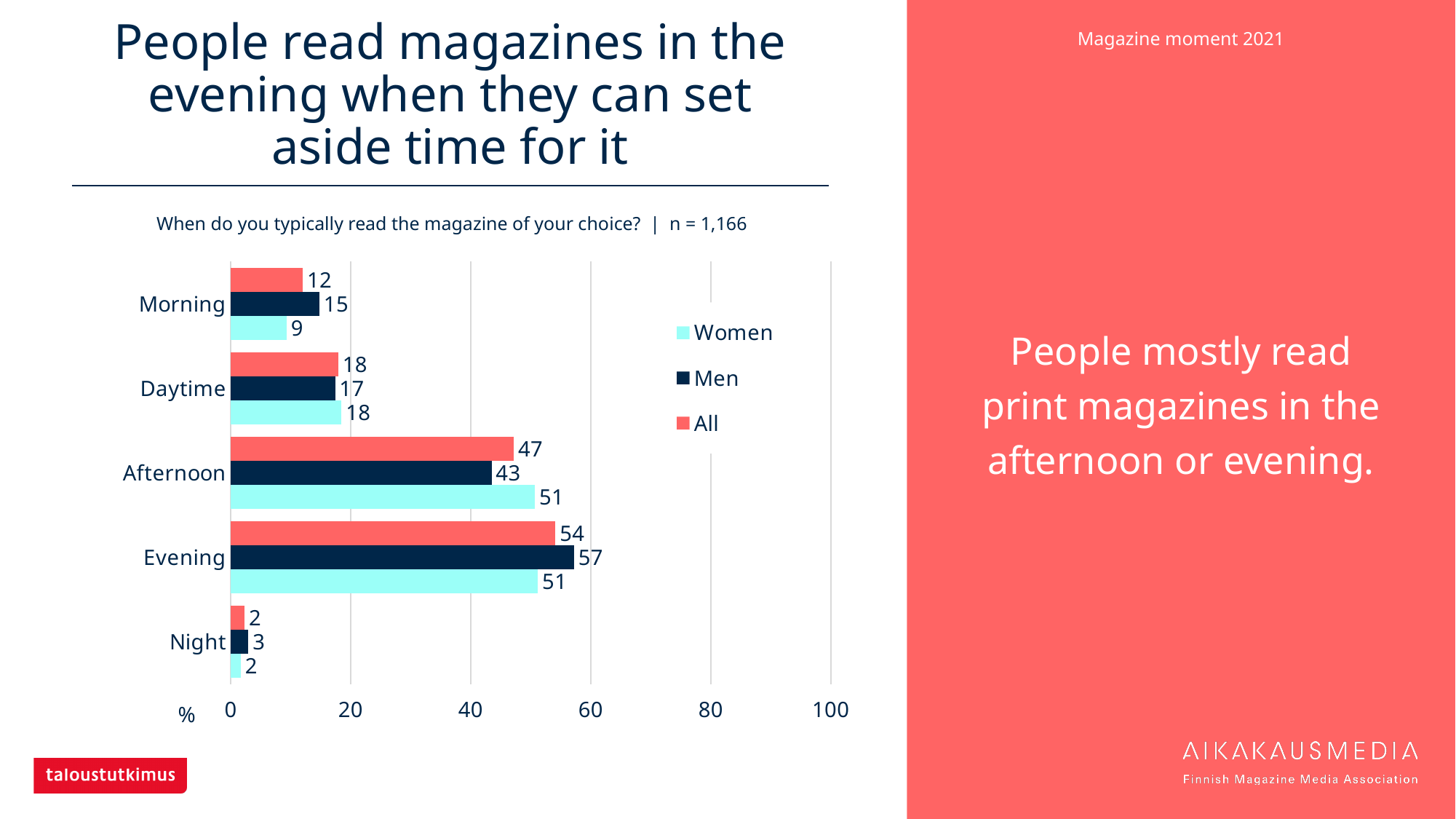
Which category has the lowest value for the Men series? Night Which is larger in the Morning category, the value for Men or the value for Women? Men What is the value for Men in the Evening category? 57 What is the difference between the Men and Women values in the Afternoon category? 8 Which category has the highest value for the All series? Evening Is the value for Women in the Evening category greater or less than 40? greater How many series does the legend list? 3 What is the sample size (n) stated above the chart? 1,166 What kind of chart is shown on the slide? bar chart What is the value for Women in the Morning category? 9 What is the value for All in the Afternoon category? 47 How many categories are shown on the chart? 5